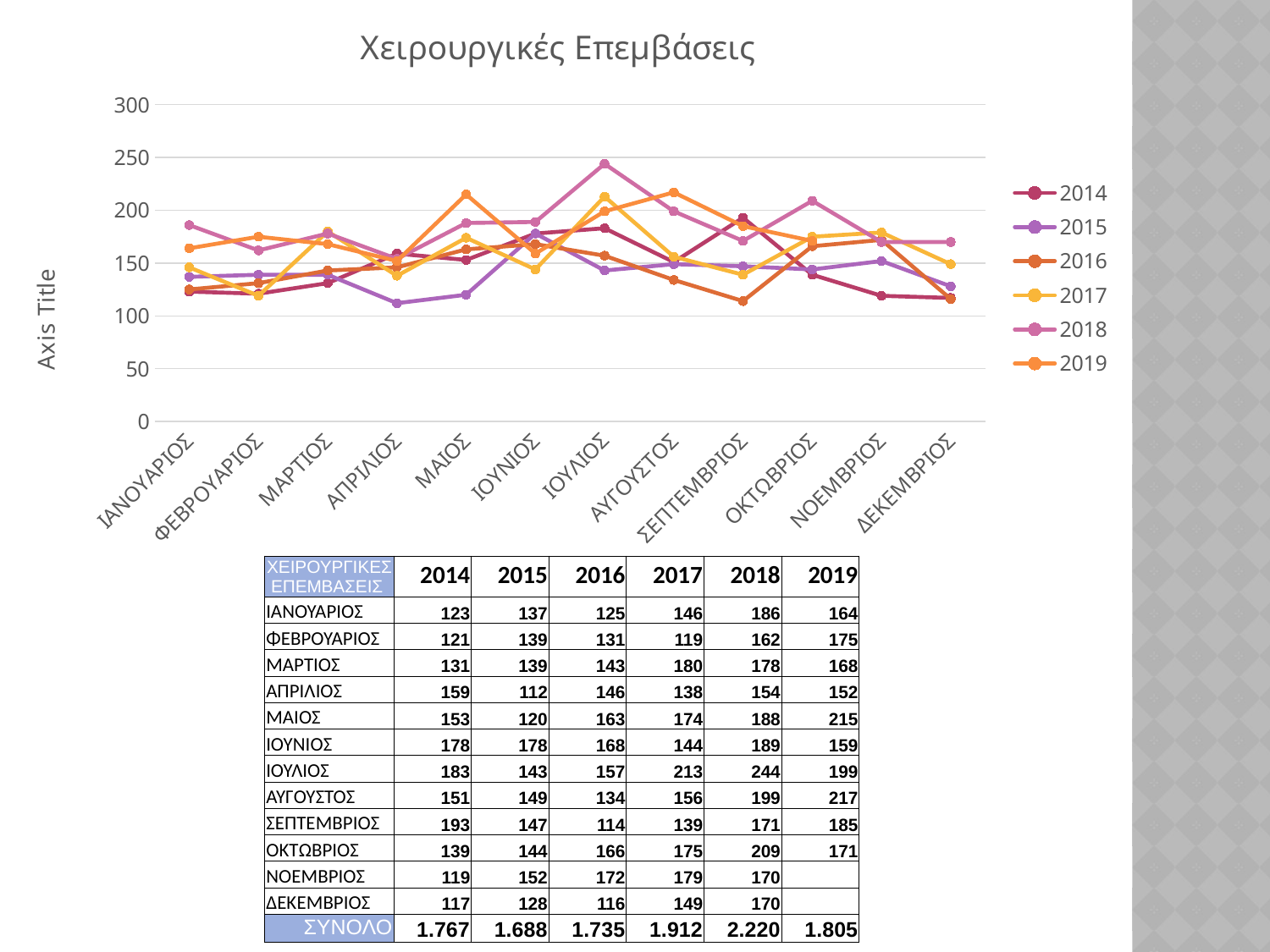
How many categories (months) are plotted along the x axis? 12 What is the value for 2015 in ΑΠΡΙΛΙΟΣ? 112 What kind of chart is shown on the slide? line chart Which is larger in ΜΑΙΟΣ, the 2019 value or the 2016 value? 2019 How many series does the legend list? 6 What is the difference between the 2018 and 2014 values in ΙΟΥΛΙΟΣ? 61 What is the value for 2018 in ΙΟΥΛΙΟΣ? 244 Is the value for 2018 in ΙΟΥΛΙΟΣ greater or less than 200? greater Which month has the highest value for the 2018 series? ΙΟΥΛΙΟΣ Does the 2014 series rise or fall from ΣΕΠΤΕΜΒΡΙΟΣ to ΔΕΚΕΜΒΡΙΟΣ? fall Which month has the lowest value for the 2014 series? ΔΕΚΕΜΒΡΙΟΣ What is the value for 2019 in ΜΑΙΟΣ? 215